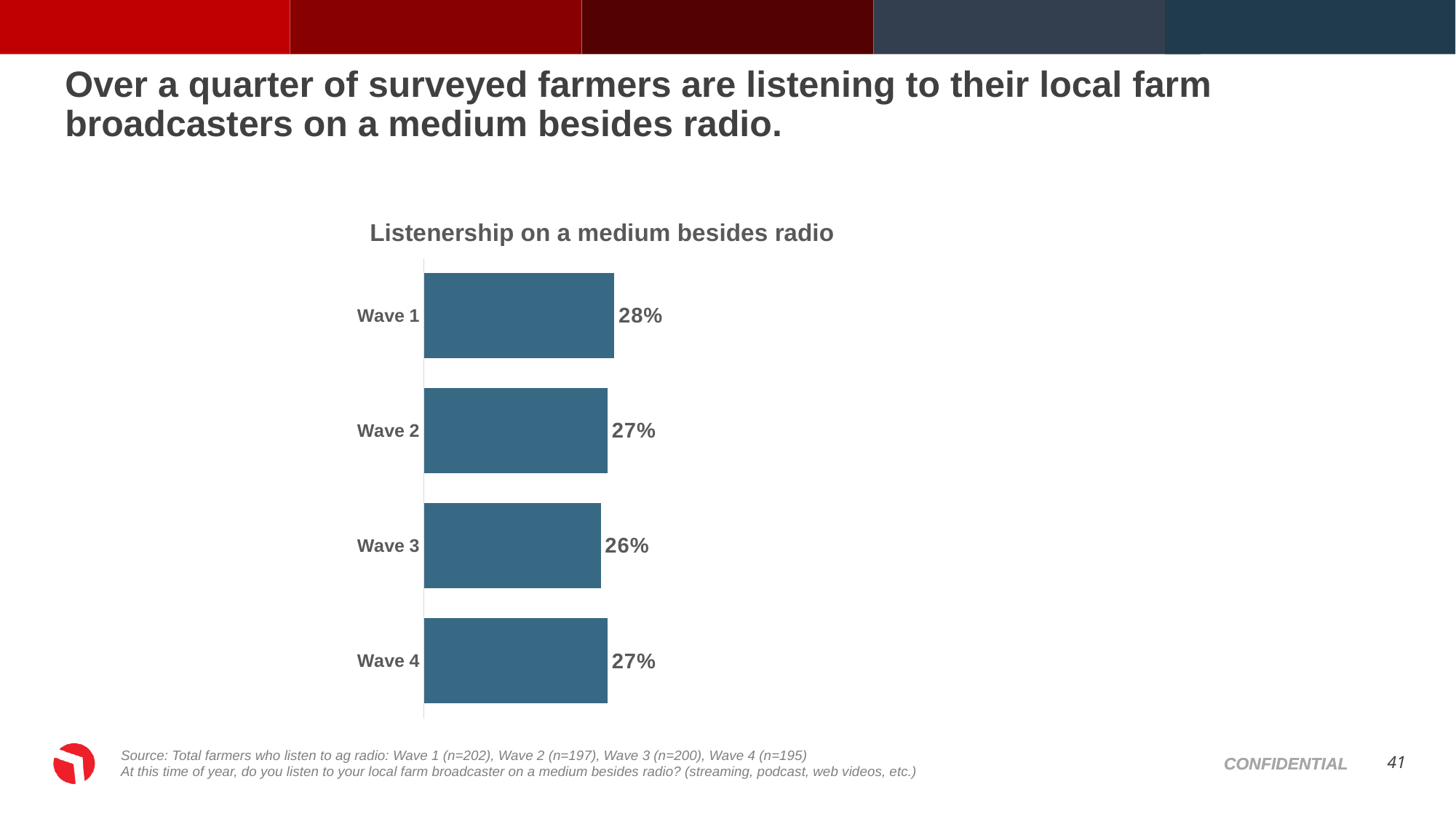
What is the value for Wave 1? 28% What is the value for Wave 3? 26% Do the values for Wave 2 and Wave 4 match? Yes, both are 27% What is the title of the chart? Listenership on a medium besides radio How many waves are shown in the chart? 4 What is the difference between the values for Wave 1 and Wave 3? 2% What kind of chart is shown on the slide? Bar chart What is the difference between the values for Wave 2 and Wave 3? 1% What is the value for Wave 4? 27% Which wave has the highest listenership on a medium besides radio? Wave 1 Which wave has the lowest listenership on a medium besides radio? Wave 3 Which is larger, the value for Wave 1 or the value for Wave 3? Wave 1